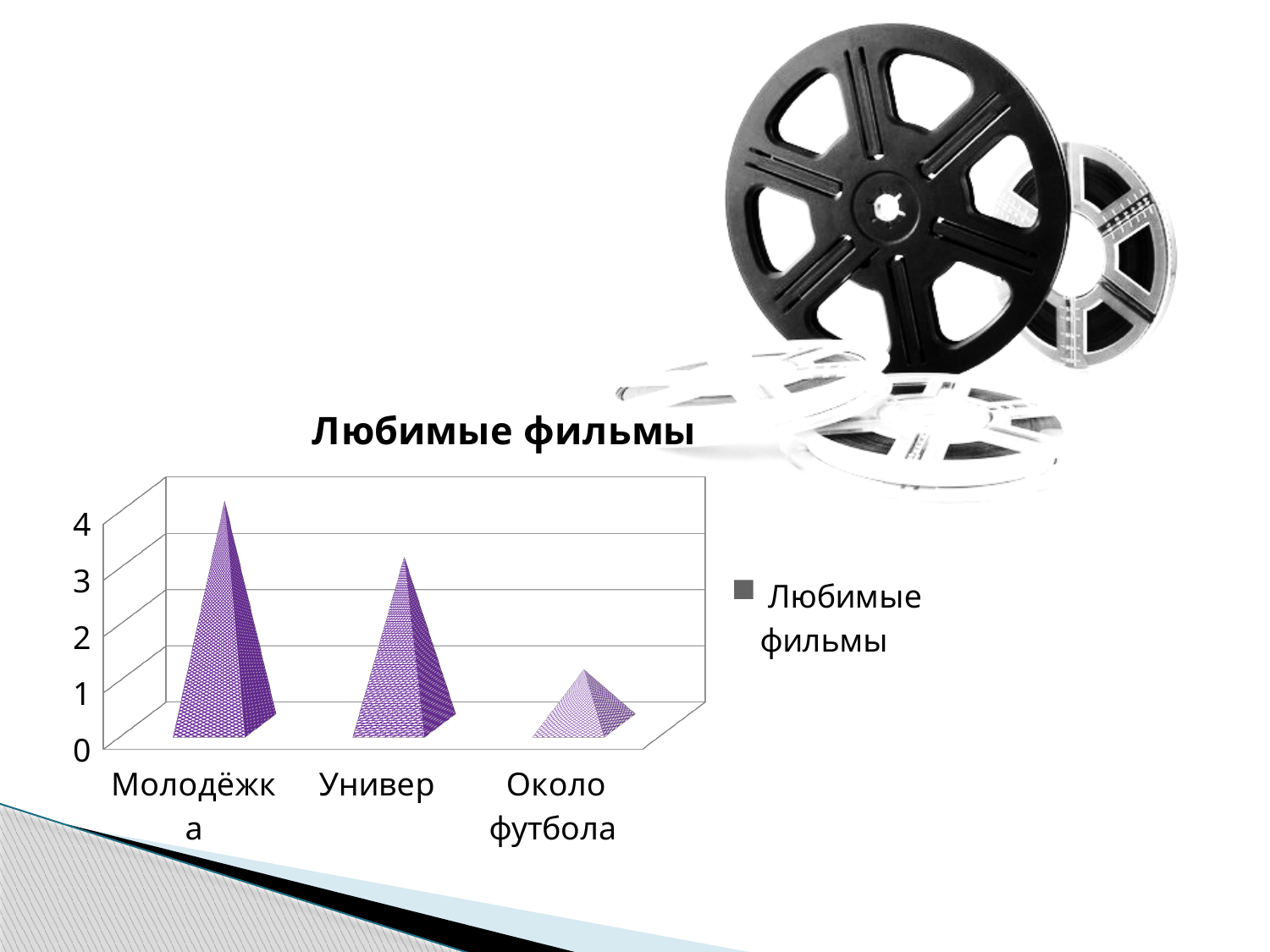
What is the title of the chart? Любимые фильмы Which is larger, the value for Универ or the value for Около футбола? Универ Which category has the highest value? Молодёжка How many series does the legend list? 1 Which category has the lowest value? Около футбола Is the value for Молодёжка greater or less than 3? greater How many categories are shown on the x axis of the chart? 3 Do the values rise or fall from left to right along the x axis? fall Is the value for Около футбола greater or less than 2? less What is the name of the series listed in the legend? Любимые фильмы What kind of chart is shown on the slide? bar chart Which is larger, the value for Молодёжка or the value for Универ? Молодёжка